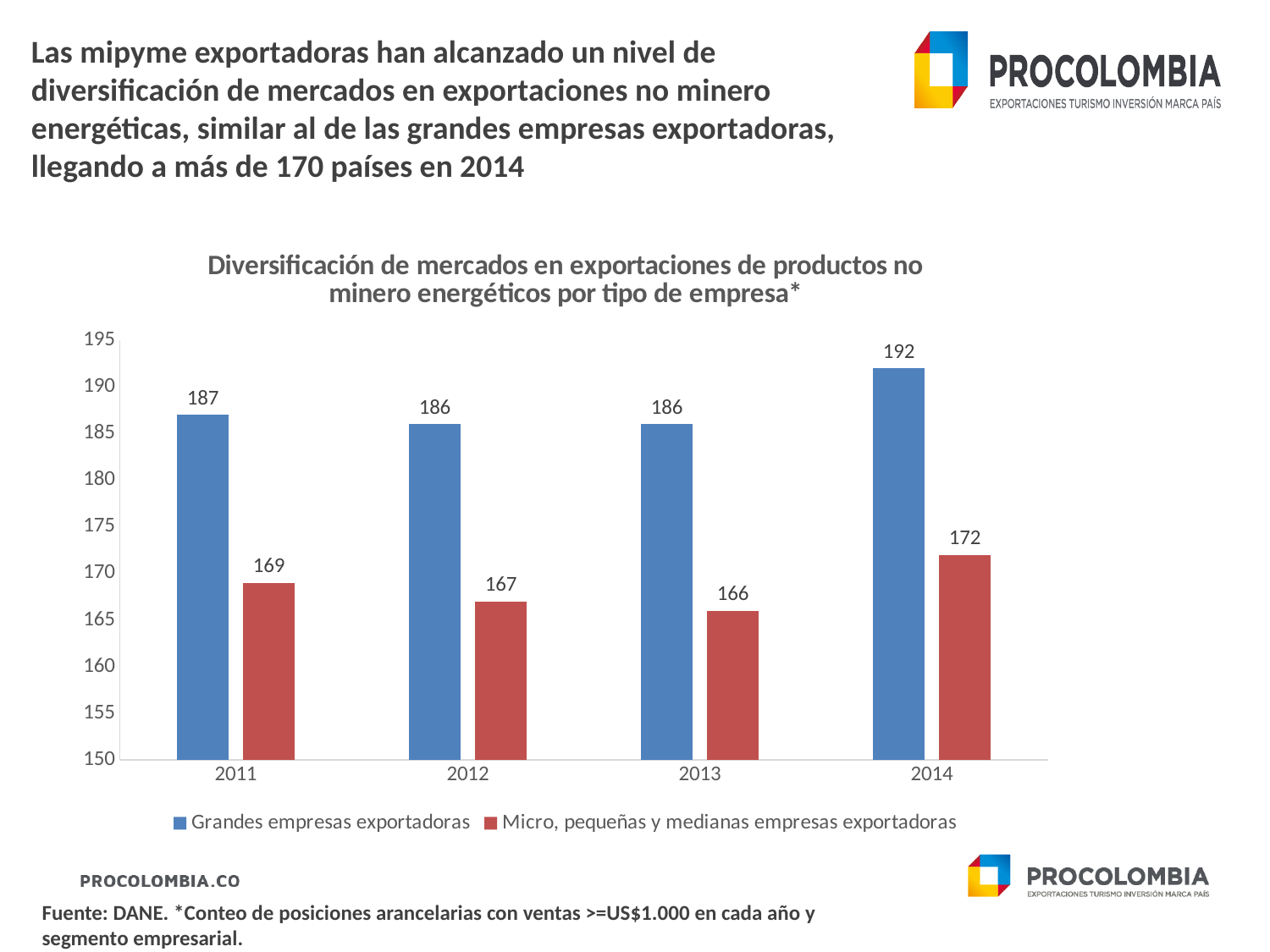
Is the value for Micro, pequeñas y medianas empresas exportadoras in 2014 greater or less than 170? greater What kind of chart is shown on the slide? Bar chart What is the value for Micro, pequeñas y medianas empresas exportadoras in 2012? 167 What is the value for Micro, pequeñas y medianas empresas exportadoras in 2011? 169 What is the difference between the 2011 and 2014 values for Micro, pequeñas y medianas empresas exportadoras? 3 Which is larger in 2013: Grandes empresas exportadoras or Micro, pequeñas y medianas empresas exportadoras? Grandes empresas exportadoras What is the value for Grandes empresas exportadoras in 2014? 192 How many years are shown on the x axis? 4 In which year is the value for Grandes empresas exportadoras highest? 2014 What is the difference between Grandes empresas exportadoras and Micro, pequeñas y medianas empresas exportadoras in 2014? 20 In which year is the value for Micro, pequeñas y medianas empresas exportadoras lowest? 2013 How many series does the legend list? 2